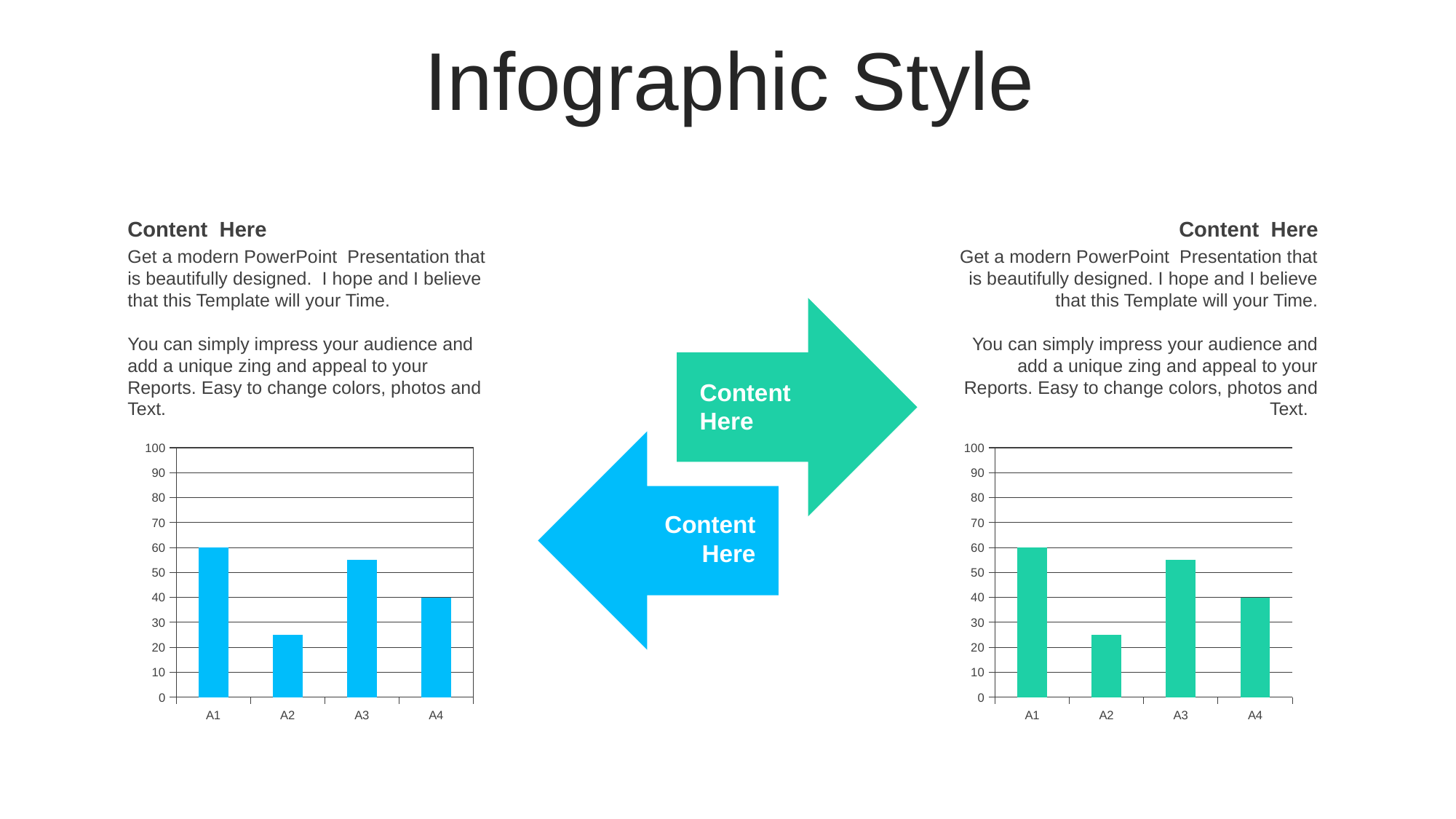
In the left chart, what is the difference between the values for A1 and A4? 20 What type of chart is the left chart on the slide? bar chart What colour are the bars in the right chart? green How many categories does the left chart show? 4 In the left chart, what is the value for A1? 60 In the left chart, which category has the lowest value? A2 In the left chart, is the value for A2 greater or less than 30? less In the right chart, is the value for A3 greater or less than 50? greater In the right chart, what is the value for A1? 60 In the left chart, what is the value for A4? 40 In the left chart, which category has the highest value? A1 In the right chart, which is larger, the value for A3 or the value for A4? A3